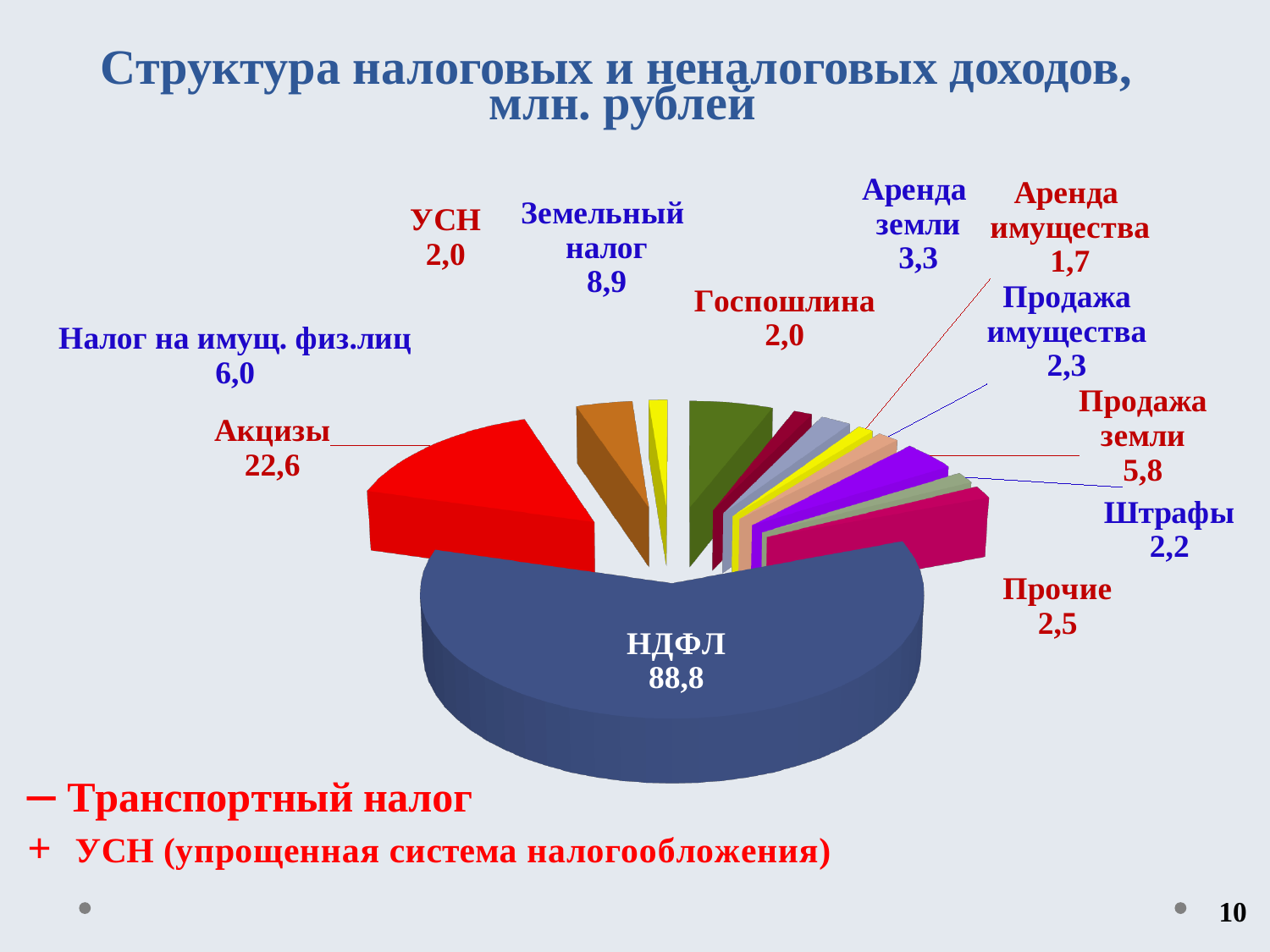
How many categories are shown in the pie chart? 12 What is the value for Продажа земли? 5,8 Which category has the smallest value? Аренда имущества What is the title of the chart? Структура налоговых и неналоговых доходов, млн. рублей What is the value for Земельный налог? 8,9 What is the value for НДФЛ? 88,8 Which category has the largest value? НДФЛ What is the difference between the values for НДФЛ and Акцизы? 66,2 What is the value for Аренда имущества? 1,7 What type of chart is shown on the slide? Pie chart Which is larger, Налог на имущ. физ.лиц or Продажа земли? Налог на имущ. физ.лиц What is the value for Акцизы? 22,6